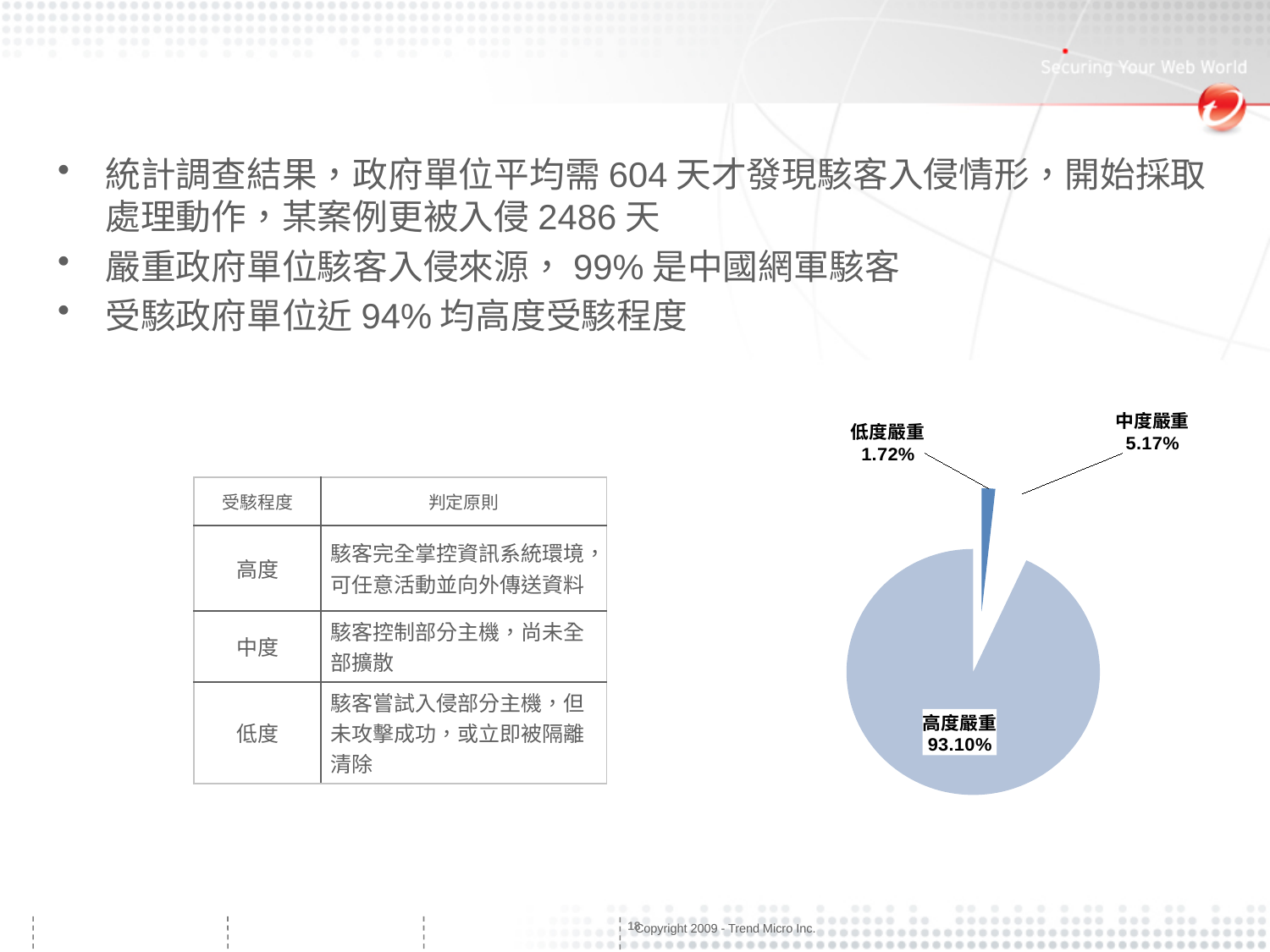
What is the difference between the 高度嚴重 and 中度嚴重 values in the pie chart? 87.93% What share of the pie does the 高度嚴重 slice represent? 93.10% What is the difference between the 中度嚴重 and 低度嚴重 values in the pie chart? 3.45% Which slice of the pie chart is the smallest? 低度嚴重 Which slice of the pie chart is the largest? 高度嚴重 What is the value shown for 中度嚴重 in the pie chart? 5.17% Which slice of the pie chart is drawn in dark blue? 低度嚴重 What is the value shown for 低度嚴重 in the pie chart? 1.72% What kind of chart is shown on the slide? pie chart Which is larger in the pie chart, 中度嚴重 or 低度嚴重? 中度嚴重 How many slices does the pie chart have? 3 What is the value shown for 高度嚴重 in the pie chart? 93.10%